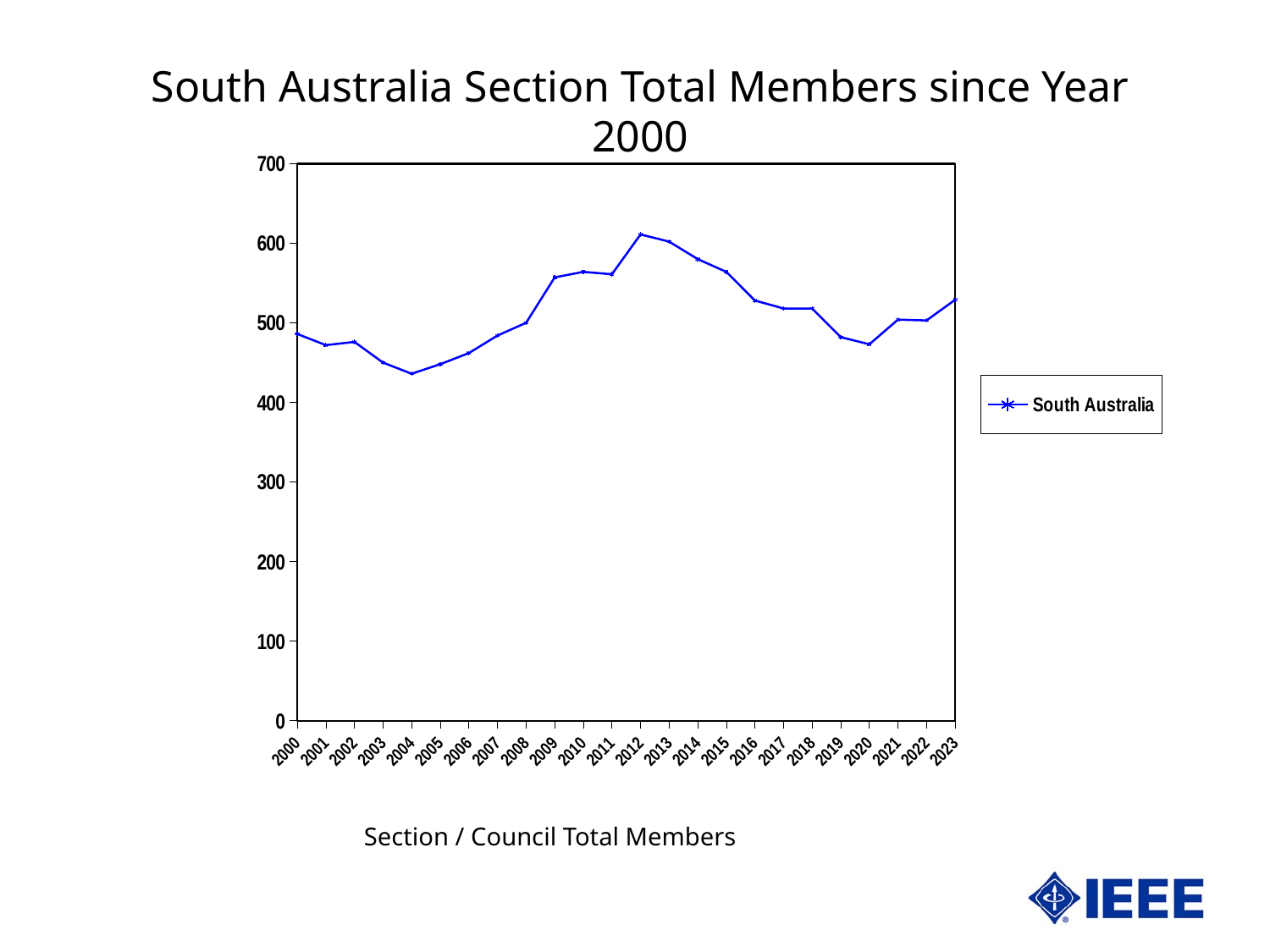
In which year is the number of South Australia members lowest? 2004 Is the value for 2004 greater or less than 500? less What kind of chart is shown on the slide? line chart Is the value for 2012 greater or less than 600? greater What is the name of the series shown in the legend? South Australia Do the values rise or fall between 2004 and 2012? rise Is the value for 2020 greater or less than 500? less In which year is the number of South Australia members highest? 2012 How many years are plotted along the x axis? 24 Do the values rise or fall between 2012 and 2020? fall Which year has the larger value, 2009 or 2020? 2009 How many series does the legend list? 1